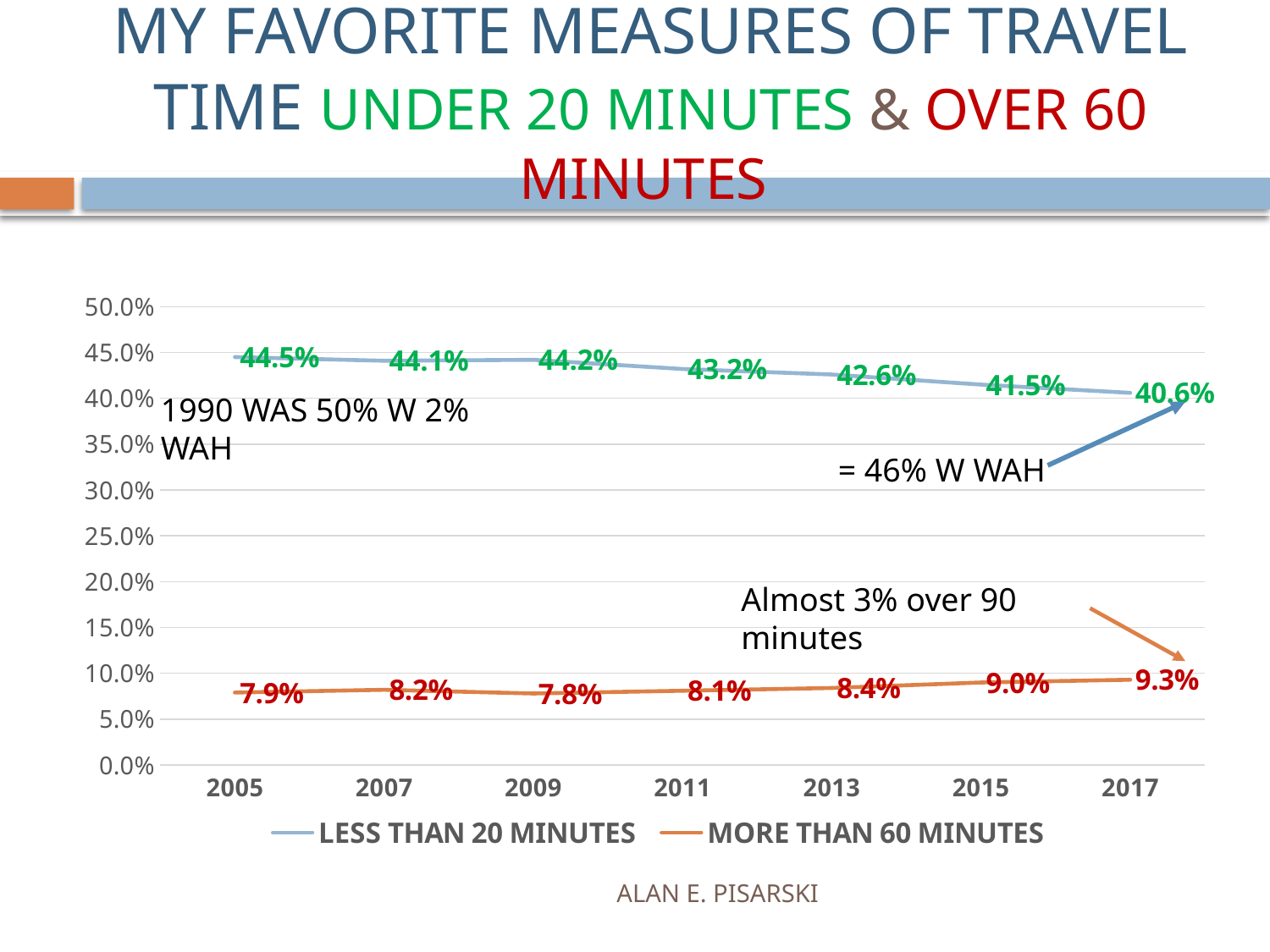
Which is larger: MORE THAN 60 MINUTES in 2015 or in 2011? 2015 In which year is the LESS THAN 20 MINUTES series highest? 2005 How many years are shown on the x axis? 7 In which year is the MORE THAN 60 MINUTES series lowest? 2009 How many series does the legend list? 2 What is the value for LESS THAN 20 MINUTES in 2005? 44.5% What is the value for MORE THAN 60 MINUTES in 2017? 9.3% What kind of chart is shown on the slide? line chart What is the difference between the LESS THAN 20 MINUTES values in 2005 and 2017? 3.9% Does the MORE THAN 60 MINUTES series rise or fall from 2011 to 2017? rise What is the value for LESS THAN 20 MINUTES in 2013? 42.6% Is the value for LESS THAN 20 MINUTES in 2017 greater or less than 45.0%? less